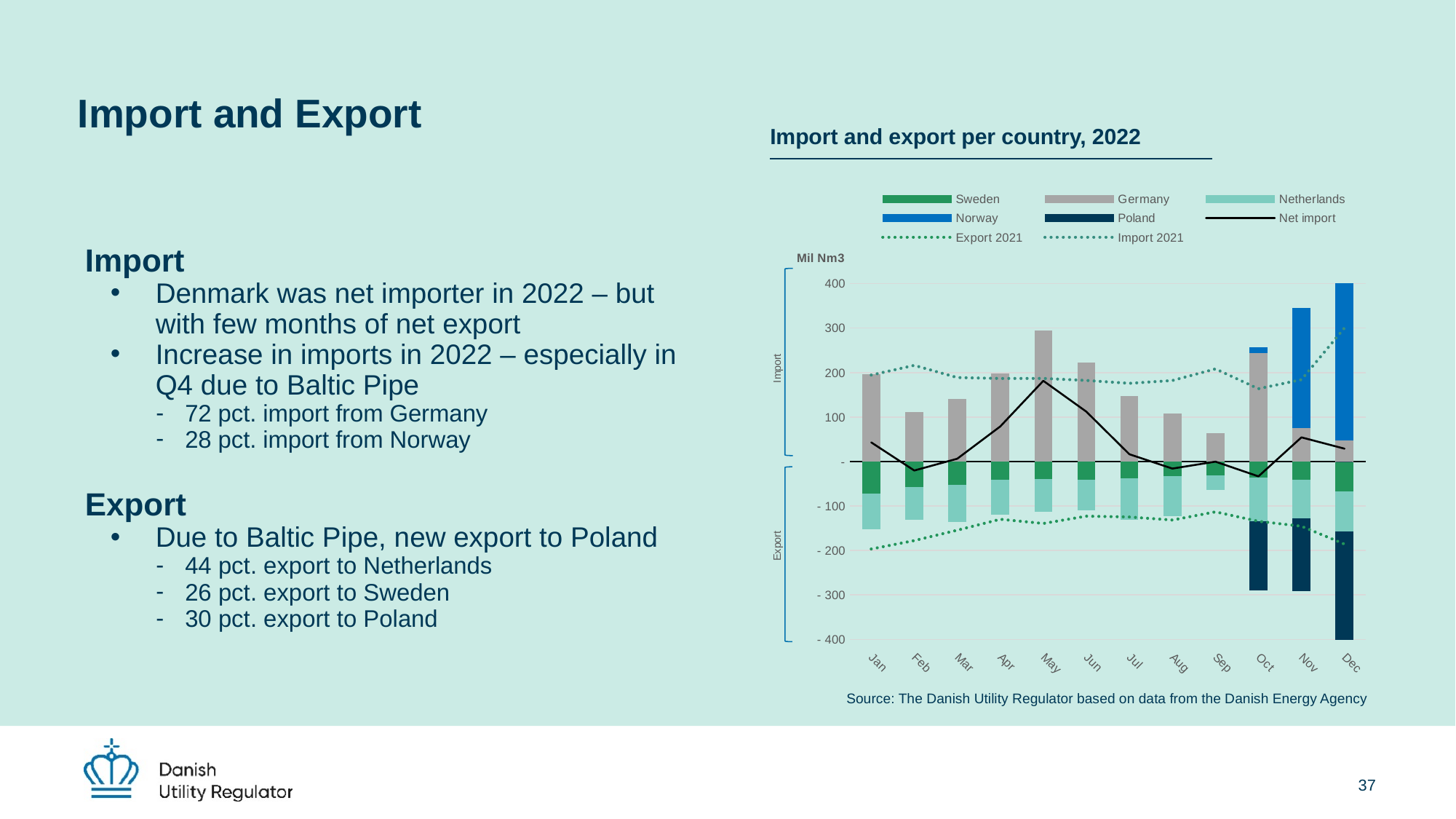
What type of chart is used to show import and export per country? Stacked bar chart with line series Is the top of the import bar in Nov greater or less than 300? greater Does the Net import line rise or fall between Apr and May? rise Which month has the largest export bar (extending furthest below zero)? Dec Is the import bar for Germany larger in May or in Jan? May Which month has the tallest import bar (above zero) in the chart? Dec Is the import from Germany in May greater or less than 200? greater How many months are shown on the x axis of the chart? 12 What unit is shown on the y axis of the chart? Mil Nm3 How many entries does the chart legend list? 8 What is the title of the chart on the slide? Import and export per country, 2022 Which month has the smallest import bar (above zero) in the chart? Sep